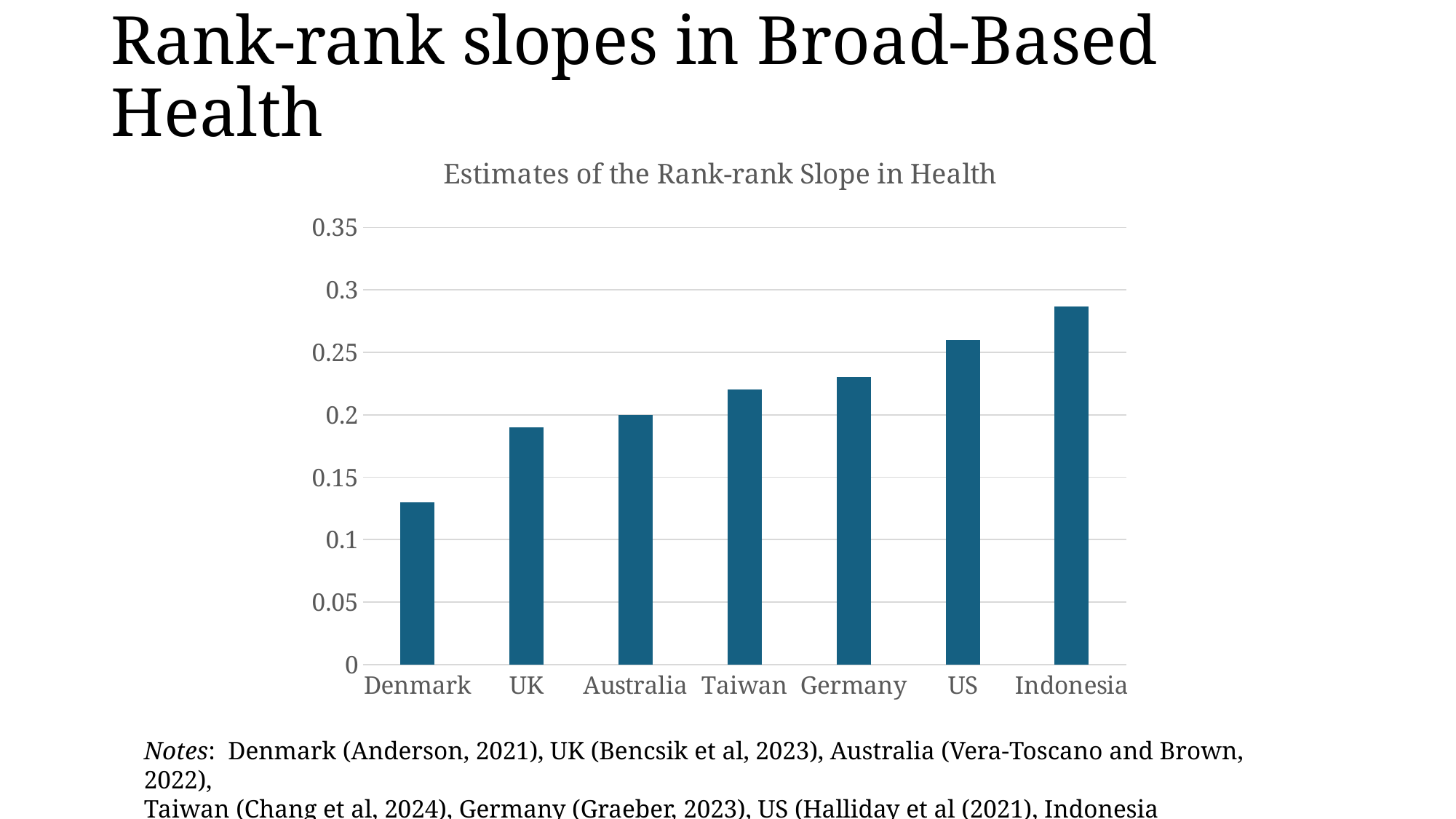
What is the rank-rank slope value for Australia? 0.2 Is the value for UK greater or less than 0.2? less Do the values rise or fall moving from left to right along the x axis? rise Is the value for Denmark greater or less than 0.15? less Which has a larger rank-rank slope, the US or the UK? US What kind of chart is shown on the slide? bar chart Is the value for Indonesia greater or less than 0.25? greater Which country has the lowest rank-rank slope in health? Denmark Which country has the highest rank-rank slope in health? Indonesia How many countries are shown on the x axis of the chart? 7 What is the title of the chart? Estimates of the Rank-rank Slope in Health